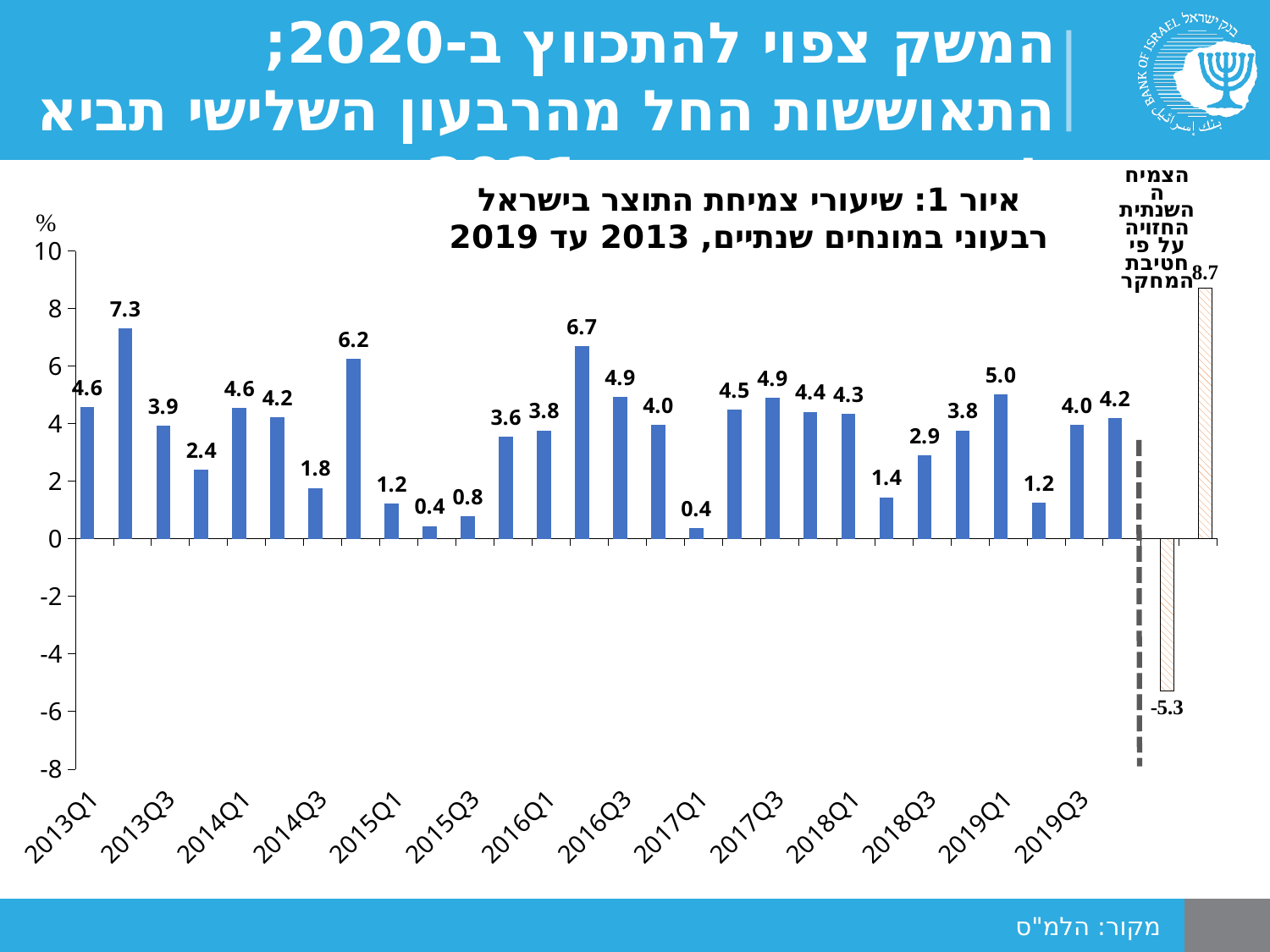
What is the value for 2019Q1? 5.0 What unit is shown at the top of the vertical axis? % What is the value for 2013Q3? 3.9 Which is larger, the value for 2013Q1 or the value for 2013Q3? 2013Q1 What is the difference between the values for 2019Q1 and 2019Q3? 1.0 Is the value for 2015Q1 greater or less than 2? less What is the value for 2013Q1? 4.6 What is the value for 2016Q1? 3.8 What is the highest value labelled on any bar in the chart? 8.7 What kind of chart is shown on the slide? bar chart What is the lowest value labelled on any bar in the chart? -5.3 What is the value for 2019Q3? 4.0